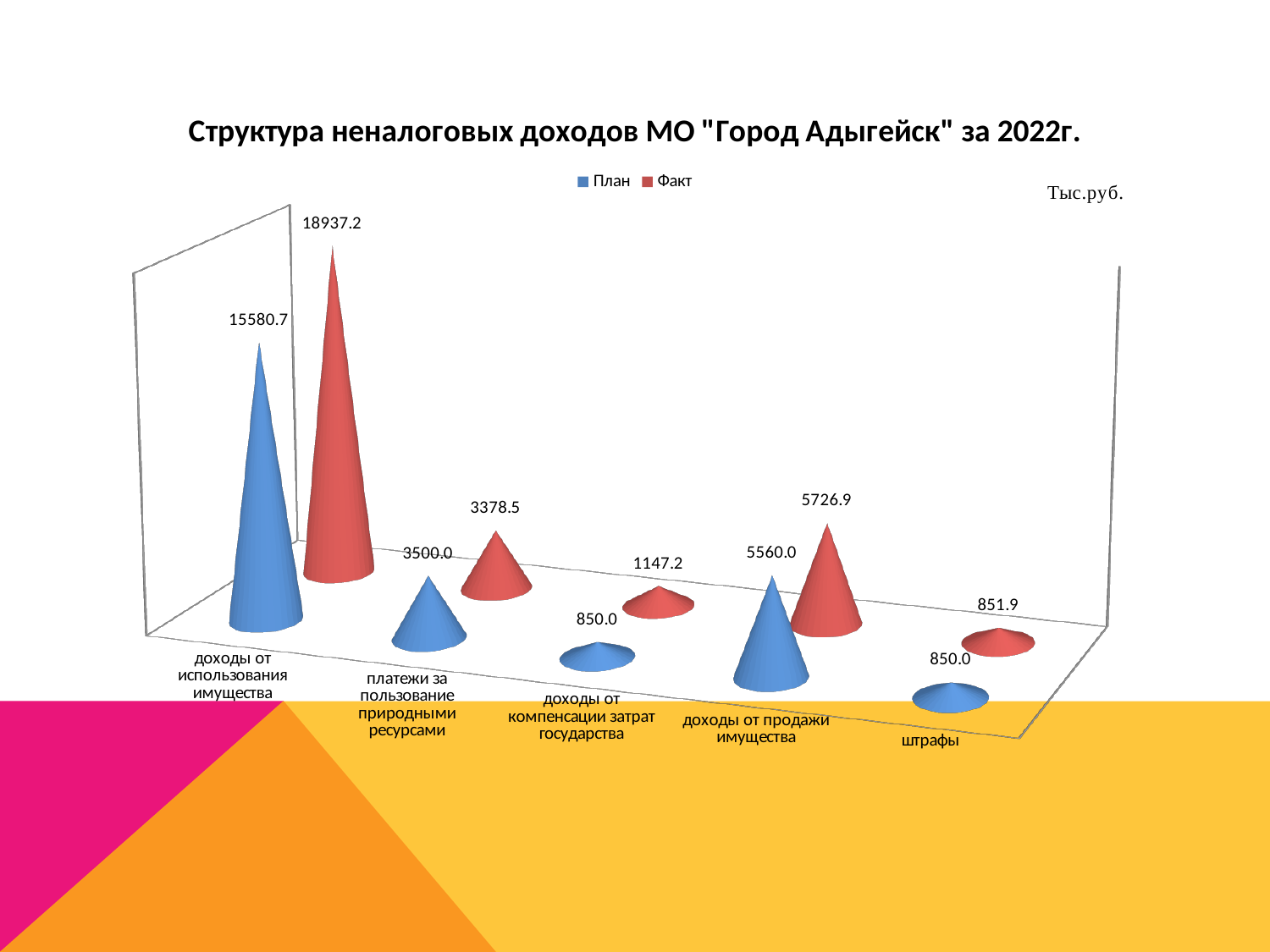
How many categories are shown on the x axis? 5 How many series does the legend list? 2 Which category has the lowest Факт value? штрафы What is the Факт value for доходы от использования имущества? 18937.2 What unit is indicated for the values on the chart? Тыс.руб. What is the difference between the Факт and План values for доходы от использования имущества? 3356.5 Which category has the highest Факт value? доходы от использования имущества What is the Факт value for платежи за пользование природными ресурсами? 3378.5 What is the План value for доходы от продажи имущества? 5560.0 What is the План value for доходы от использования имущества? 15580.7 What is the Факт value for доходы от компенсации затрат государства? 1147.2 Which is larger for платежи за пользование природными ресурсами, the План value or the Факт value? План